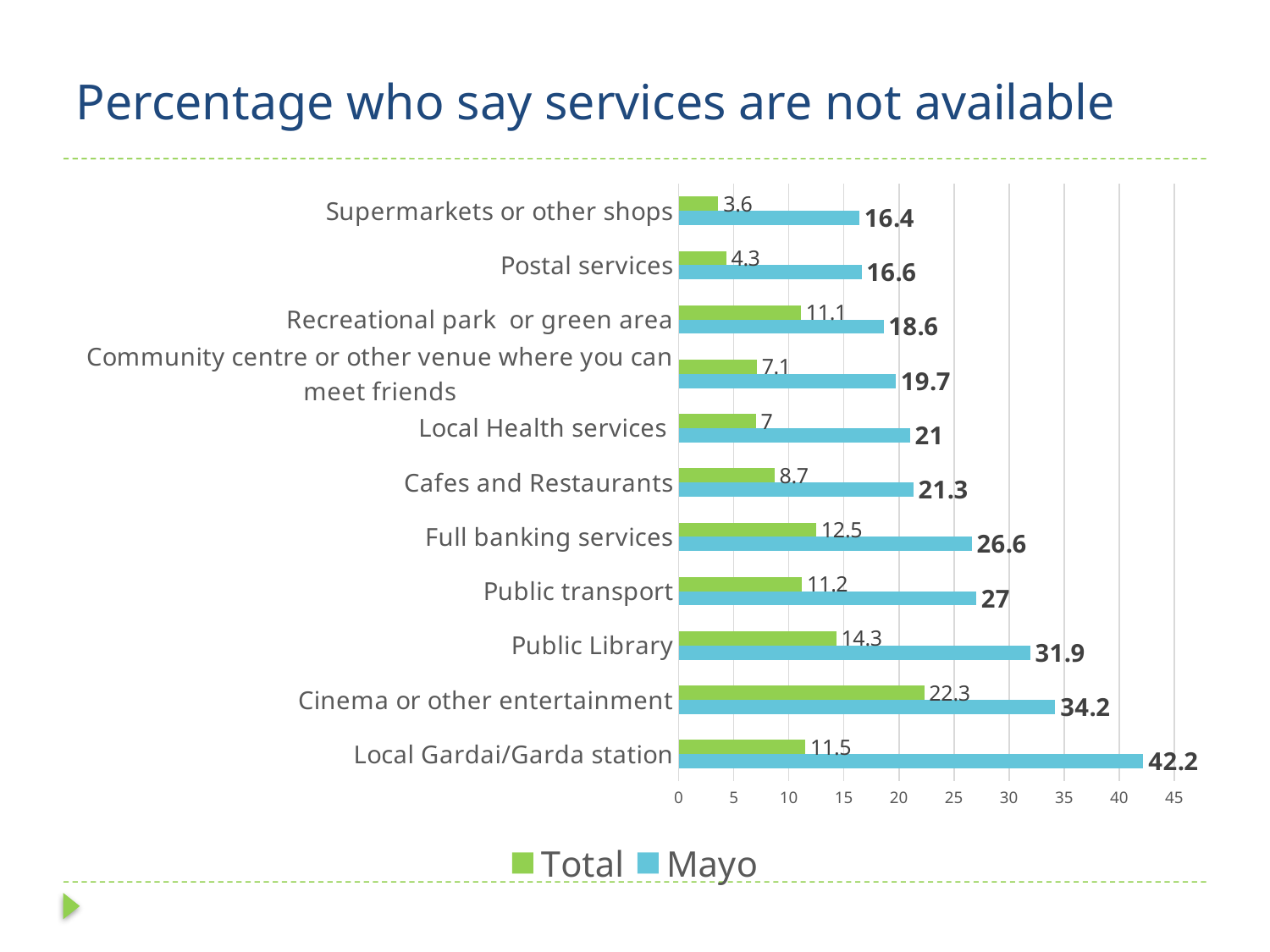
What kind of chart is shown on the slide? Bar chart What is the Mayo value for Full banking services? 26.6 How many series does the legend list? 2 Which category has the highest Mayo value? Local Gardai/Garda station Which category has the lowest Total value? Supermarkets or other shops What is the title of the chart? Percentage who say services are not available What is the Total value for Cinema or other entertainment? 22.3 What is the difference between the Mayo and Total values for Public Library? 17.6 Which is larger, the Total value for Public transport or the Total value for Recreational park or green area? Public transport How many categories are shown on the chart? 11 What is the Mayo value for Local Gardai/Garda station? 42.2 What is the Total value for Supermarkets or other shops? 3.6